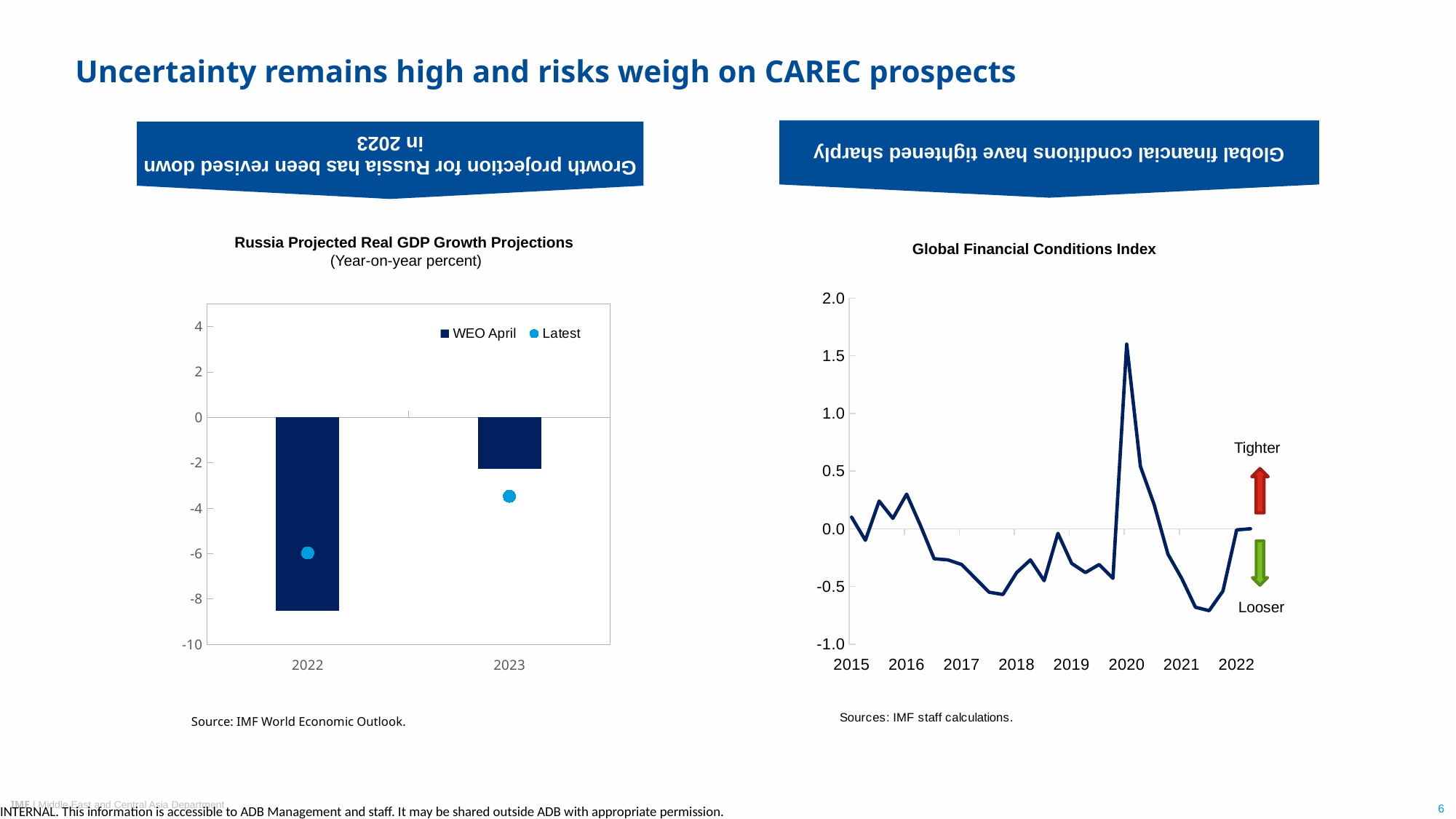
On the Russia Projected Real GDP Growth Projections chart, which year has the lowest WEO April value? 2022 On the Russia Projected Real GDP Growth Projections chart, is the WEO April value for 2022 greater or less than -8? less On the Global Financial Conditions Index chart, in which year does the line reach its highest peak? 2020 On the Russia Projected Real GDP Growth Projections chart, what kind of chart is used for the WEO April series? bar chart On the Russia Projected Real GDP Growth Projections chart, how many series does the legend list? 2 On the Global Financial Conditions Index chart, is the peak value in 2020 greater or less than 1.5? greater On the Global Financial Conditions Index chart, what label is placed next to the red upward arrow? Tighter On the Russia Projected Real GDP Growth Projections chart, is the Latest value for 2023 greater or less than -4? greater On the Russia Projected Real GDP Growth Projections chart, which is larger for 2023: the WEO April value or the Latest value? WEO April On the Russia Projected Real GDP Growth Projections chart, how many years are shown on the x axis? 2 On the Russia Projected Real GDP Growth Projections chart, which is larger for 2022: the WEO April value or the Latest value? Latest What kind of chart is the Global Financial Conditions Index chart? line chart